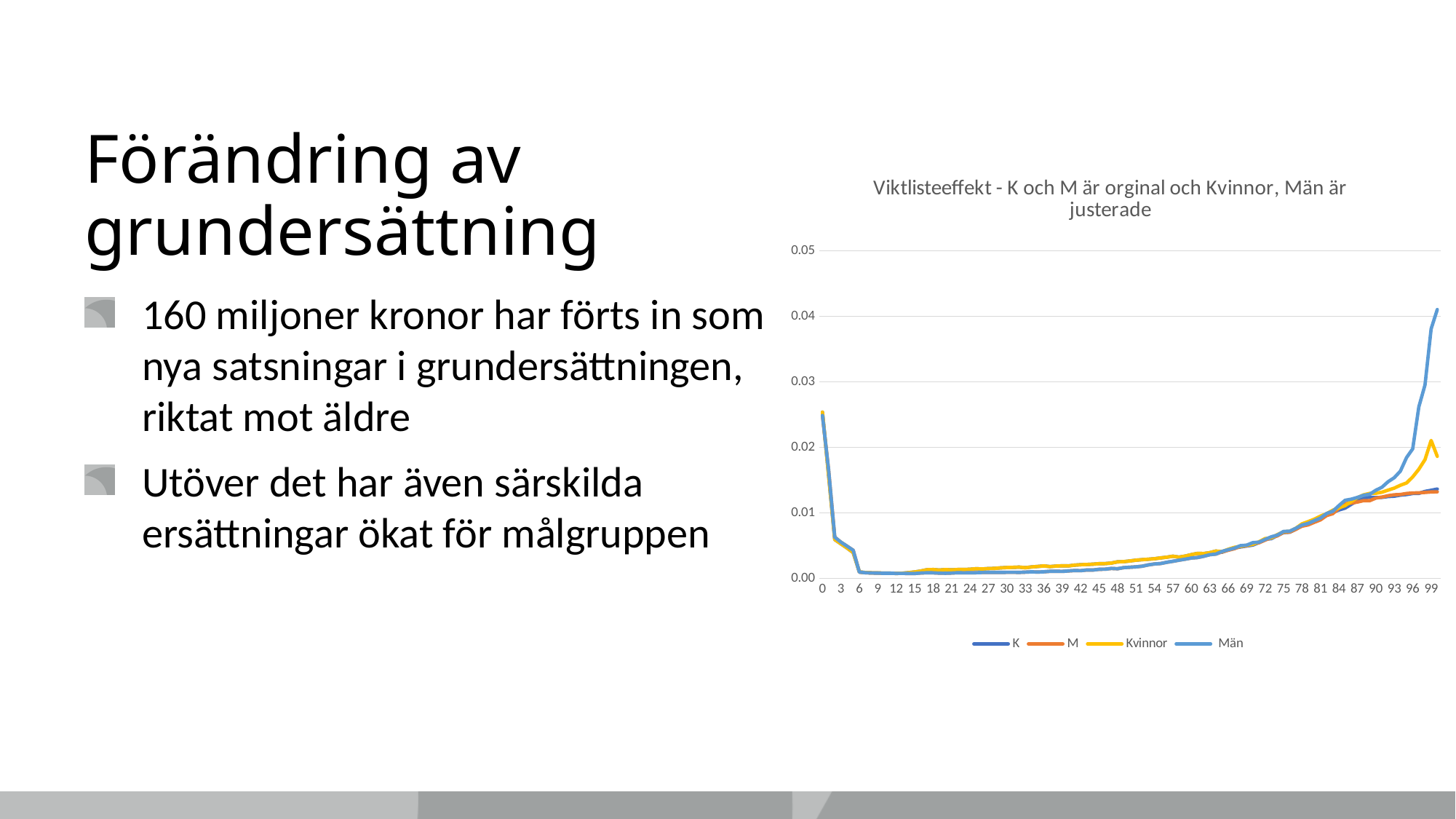
What kind of chart is shown on the slide? line chart Do the values for K rise or fall along the x axis from 0 to 6? fall How many series does the chart's legend list? 4 Is the value for Män at x = 99 greater or less than 0.03? greater Which series are listed in the chart's legend? K, M, Kvinnor, Män Is the value for Män at x = 12 greater or less than 0.01? less What is the title of the chart? Viktlisteeffekt - K och M är orginal och Kvinnor, Män är justerade Do the values for Män rise or fall along the x axis from 9 to 99? rise Is the value for K at x = 0 greater or less than 0.02? greater At x = 99, which series has the larger value, Män or Kvinnor? Män Which series reaches the highest value on the chart? Män